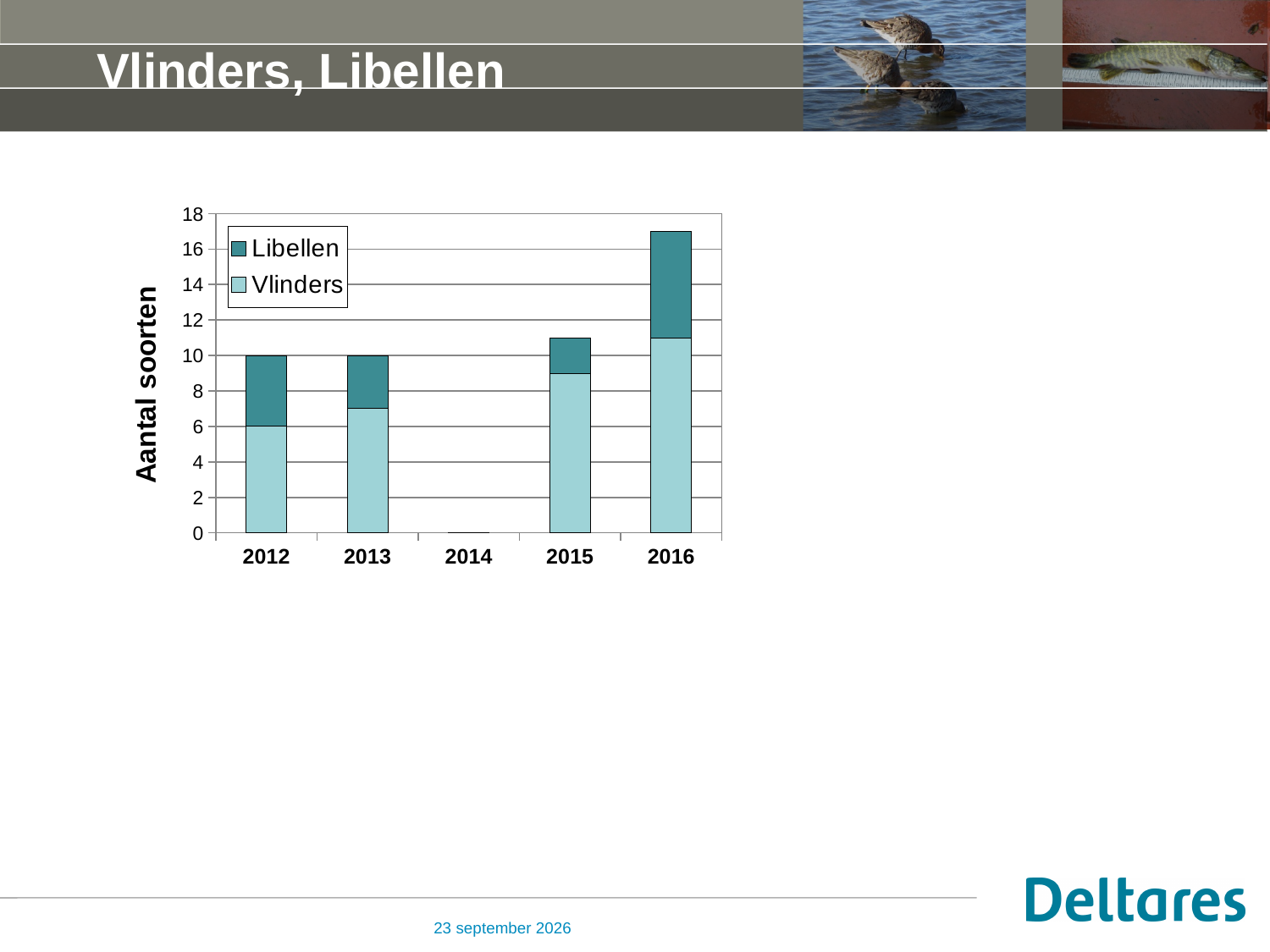
Which year has the lowest total number of species? 2014 Which year has the highest total number of species? 2016 Which two series are listed in the legend? Libellen and Vlinders How many series does the legend list? 2 What is the total height of the stacked bar for 2012? 10 What is the value for Vlinders in 2012? 6 What kind of chart is shown on the slide? Stacked bar chart How many years are shown on the x axis? 5 Is the total for 2016 greater or less than 16? greater What is the title of the vertical axis? Aantal soorten Is the value for Vlinders in 2016 greater or less than 10? greater What is the total height of the stacked bar for 2013? 10